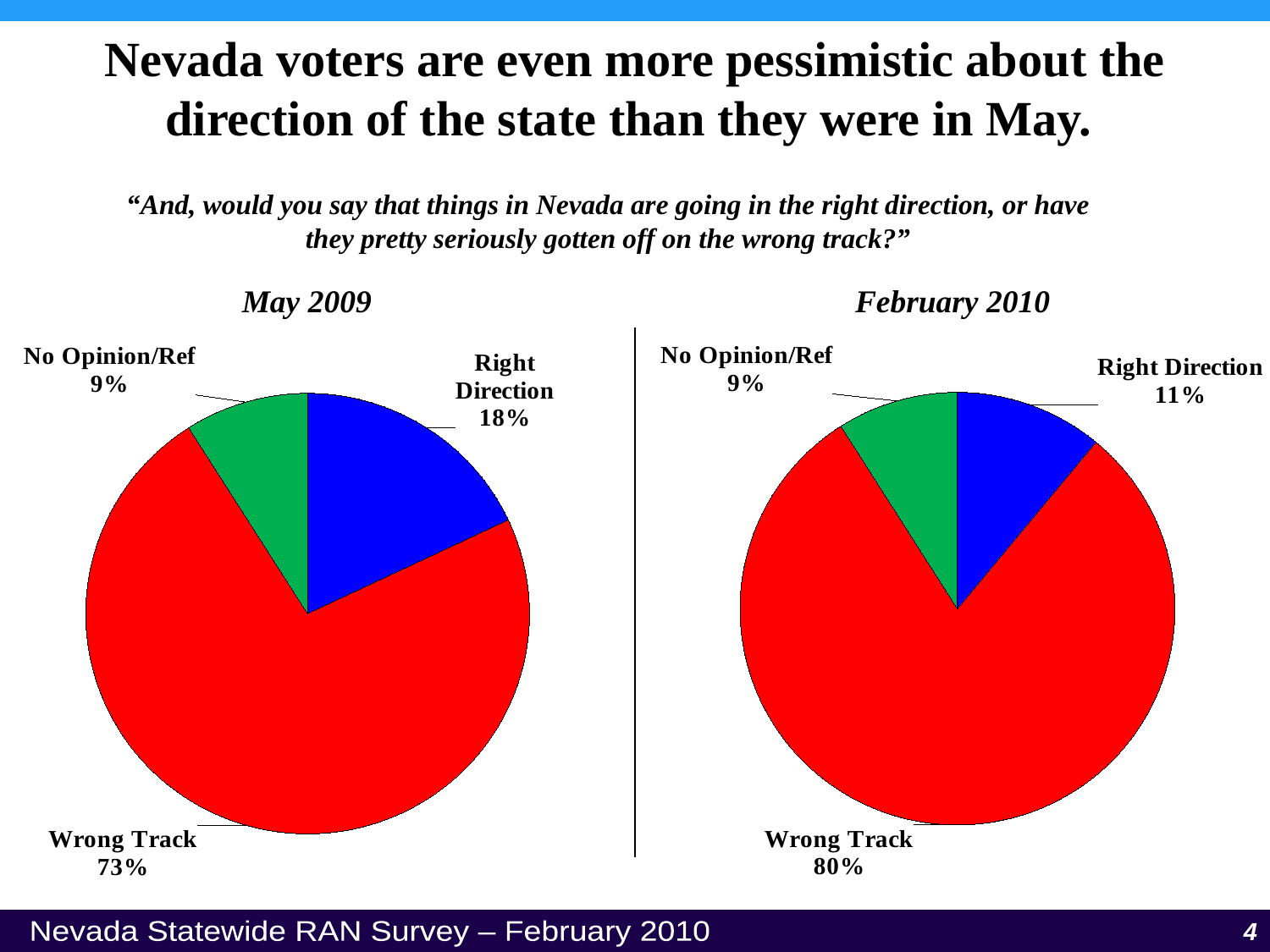
What type of chart is used on this slide? Pie chart In the May 2009 chart, what percentage said No Opinion/Ref? 9% In the May 2009 chart, what is the difference between Right Direction and No Opinion/Ref? 9% In the May 2009 chart, what percentage said Wrong Track? 73% How many slices does the February 2010 chart have? 3 Which is larger: Right Direction in May 2009 or Right Direction in February 2010? May 2009 In the February 2010 chart, what colour is the Wrong Track slice? Red In the February 2010 chart, which category has the smallest slice? No Opinion/Ref In the May 2009 chart, which category has the largest slice? Wrong Track In the February 2010 chart, what percentage said Right Direction? 11% What is the difference between the Wrong Track percentages in the February 2010 chart and the May 2009 chart? 7% In the February 2010 chart, what percentage said Wrong Track? 80%